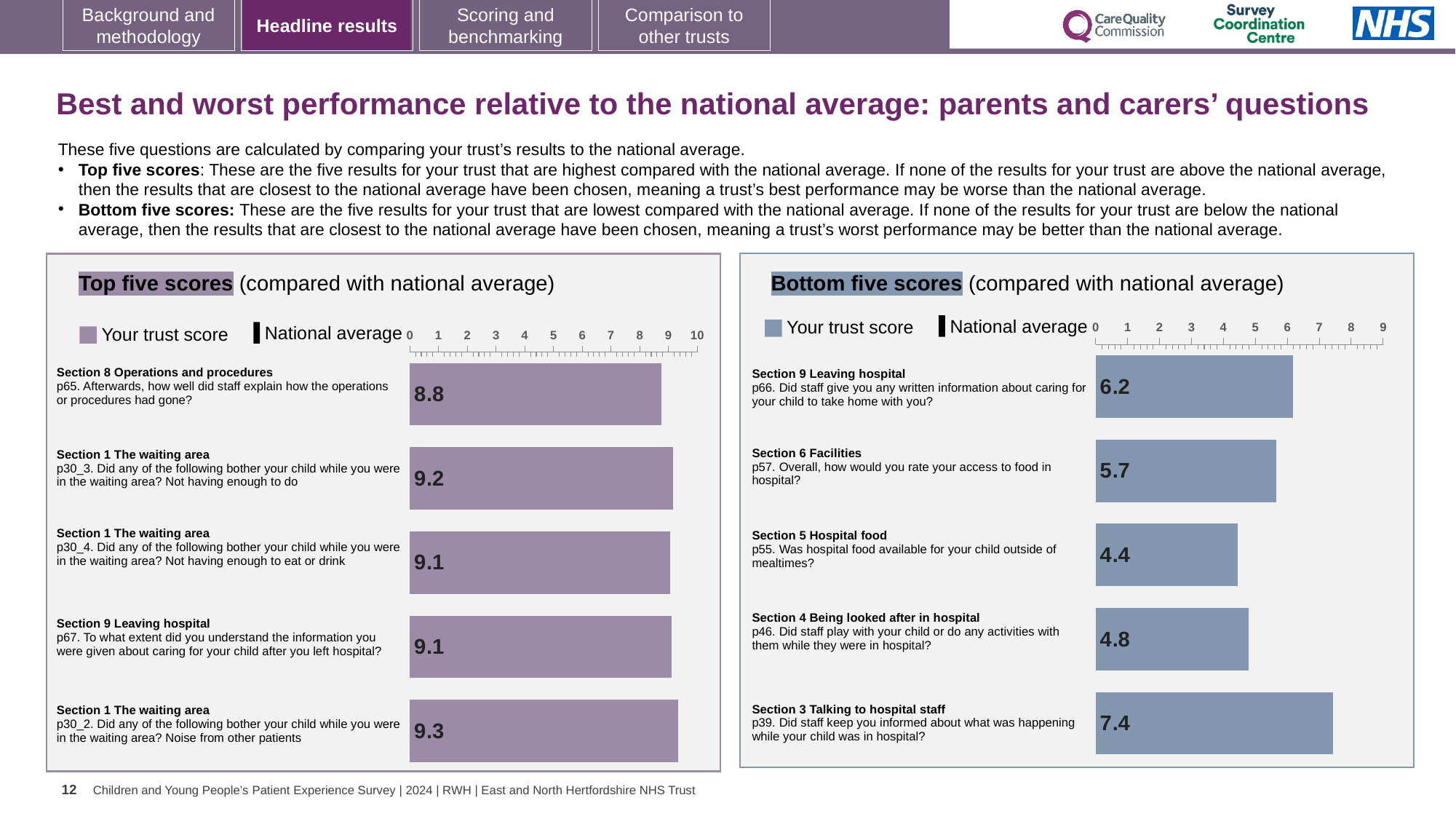
In the Top five scores chart, what is the trust score for p65 (how well did staff explain how the operations or procedures had gone)? 8.8 In the Bottom five scores chart, what is the trust score for p57 (access to food in hospital)? 5.7 What type of chart is used for the Top five scores? Bar chart In the Bottom five scores chart, which has the larger score: p66 or p46? p66 In the Top five scores chart, what is the trust score for p30_2 (noise from other patients in the waiting area)? 9.3 In the Bottom five scores chart, which question has the highest trust score? p39. Did staff keep you informed about what was happening while your child was in hospital? In the Top five scores chart, which question has the lowest trust score? p65. Afterwards, how well did staff explain how the operations or procedures had gone? In the Top five scores chart, what is the difference between the scores for p30_2 and p65? 0.5 In the Bottom five scores chart, what is the difference between the scores for p66 and p55? 1.8 In the Top five scores chart, which question has the highest trust score? p30_2. Noise from other patients In the Bottom five scores chart, which question has the lowest trust score? p55. Was hospital food available for your child outside of mealtimes? In the Bottom five scores chart, what is the trust score for p39 (did staff keep you informed about what was happening)? 7.4